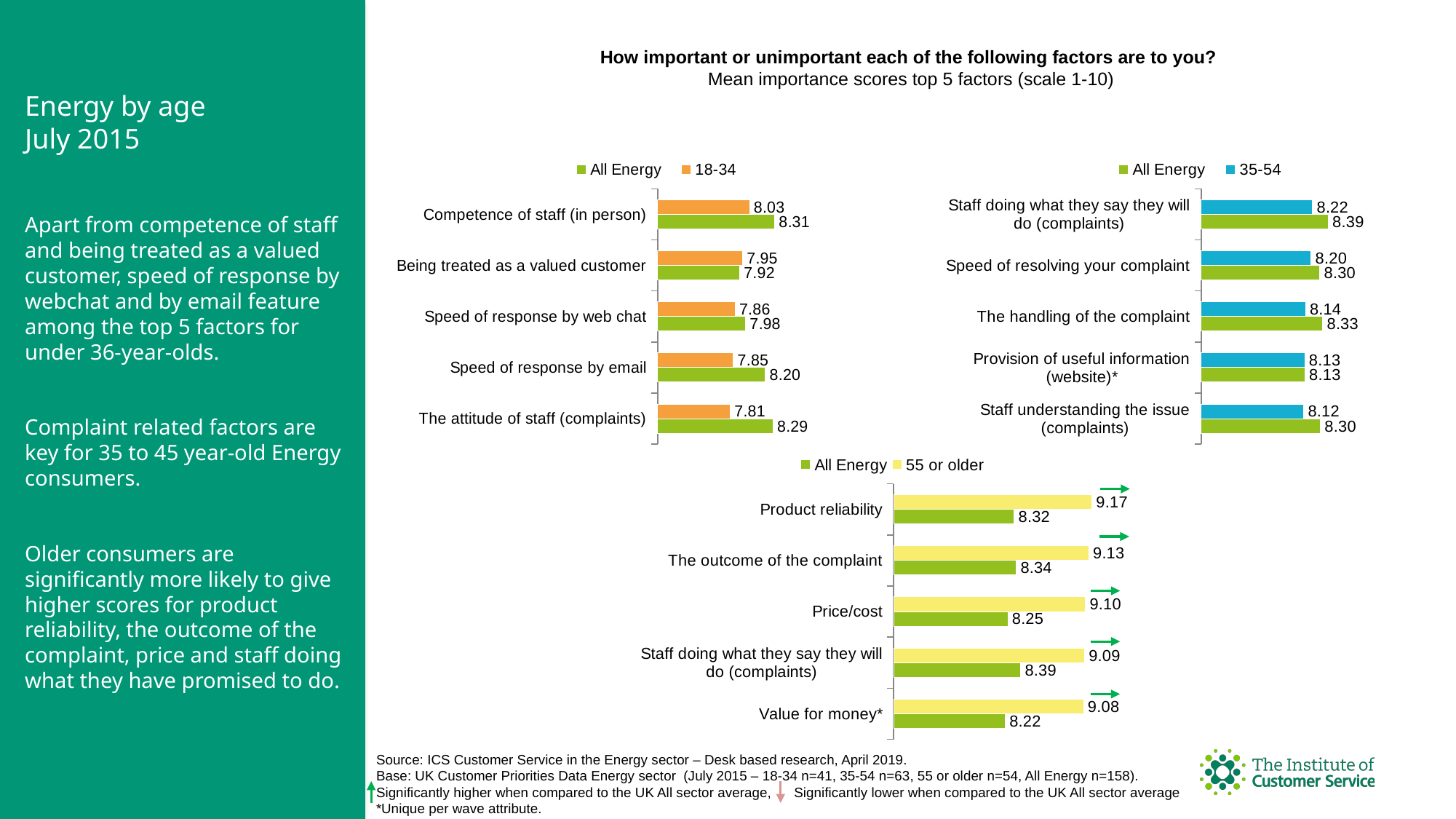
In the bottom chart (All Energy vs 55 or older), what is the difference between the 55 or older and All Energy scores for Value for money*? 0.86 In the top-left chart (All Energy vs 18-34), what is the All Energy score for Speed of response by email? 8.20 In the top-left chart (All Energy vs 18-34), what is the 18-34 score for Competence of staff (in person)? 8.03 How many series does the legend of the bottom chart (All Energy vs 55 or older) list? 2 In the top-left chart (All Energy vs 18-34), which factor has the lowest 18-34 score? The attitude of staff (complaints) What type of chart is the top-left chart (All Energy vs 18-34)? Bar chart In the top-right chart (All Energy vs 35-54), which factor has the highest 35-54 score? Staff doing what they say they will do (complaints) In the top-right chart (All Energy vs 35-54), what is the 35-54 score for Speed of resolving your complaint? 8.20 In the bottom chart (All Energy vs 55 or older), what is the 55 or older score for Product reliability? 9.17 In the top-right chart (All Energy vs 35-54), is the All Energy score or the 35-54 score larger for The handling of the complaint? All Energy In the top-left chart (All Energy vs 18-34), what is the difference between the All Energy and 18-34 scores for The attitude of staff (complaints)? 0.48 In the bottom chart (All Energy vs 55 or older), how many factors are shown? 5